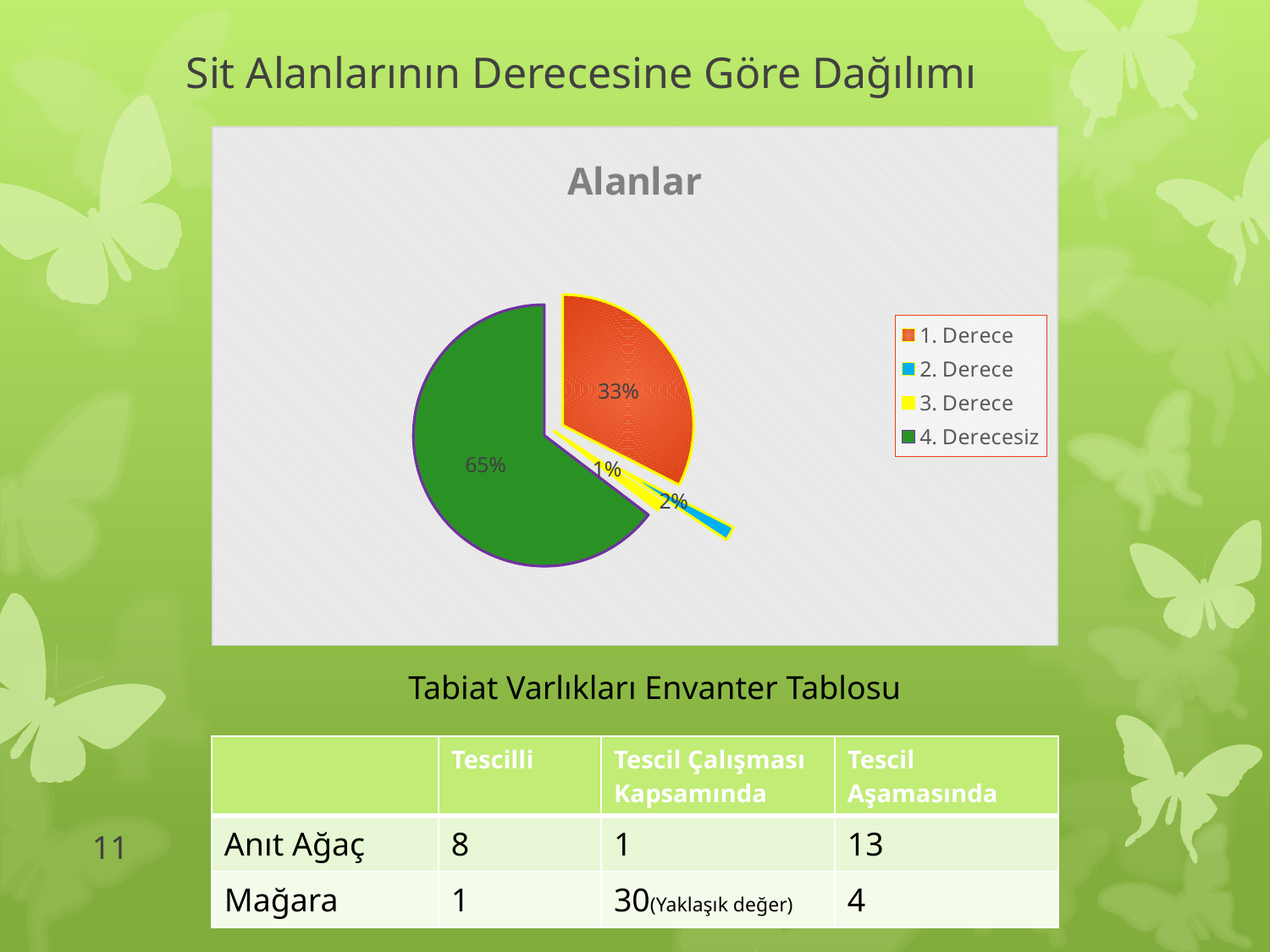
What colour is the 4. Derecesiz slice? green What percentage of the pie does 4. Derecesiz account for? 65% Is the share for 4. Derecesiz greater or less than 50%? greater What do the 1. Derece and 4. Derecesiz slices add up to? 98% Which category has the largest slice of the pie? 4. Derecesiz Which is larger, the slice for 1. Derece or the slice for 4. Derecesiz? 4. Derecesiz What percentage of the pie does 1. Derece account for? 33% What is the title of the chart? Alanlar How many categories does the legend list? 4 What kind of chart is shown on the slide? pie chart What is the difference in percentage points between the 4. Derecesiz slice and the 1. Derece slice? 32